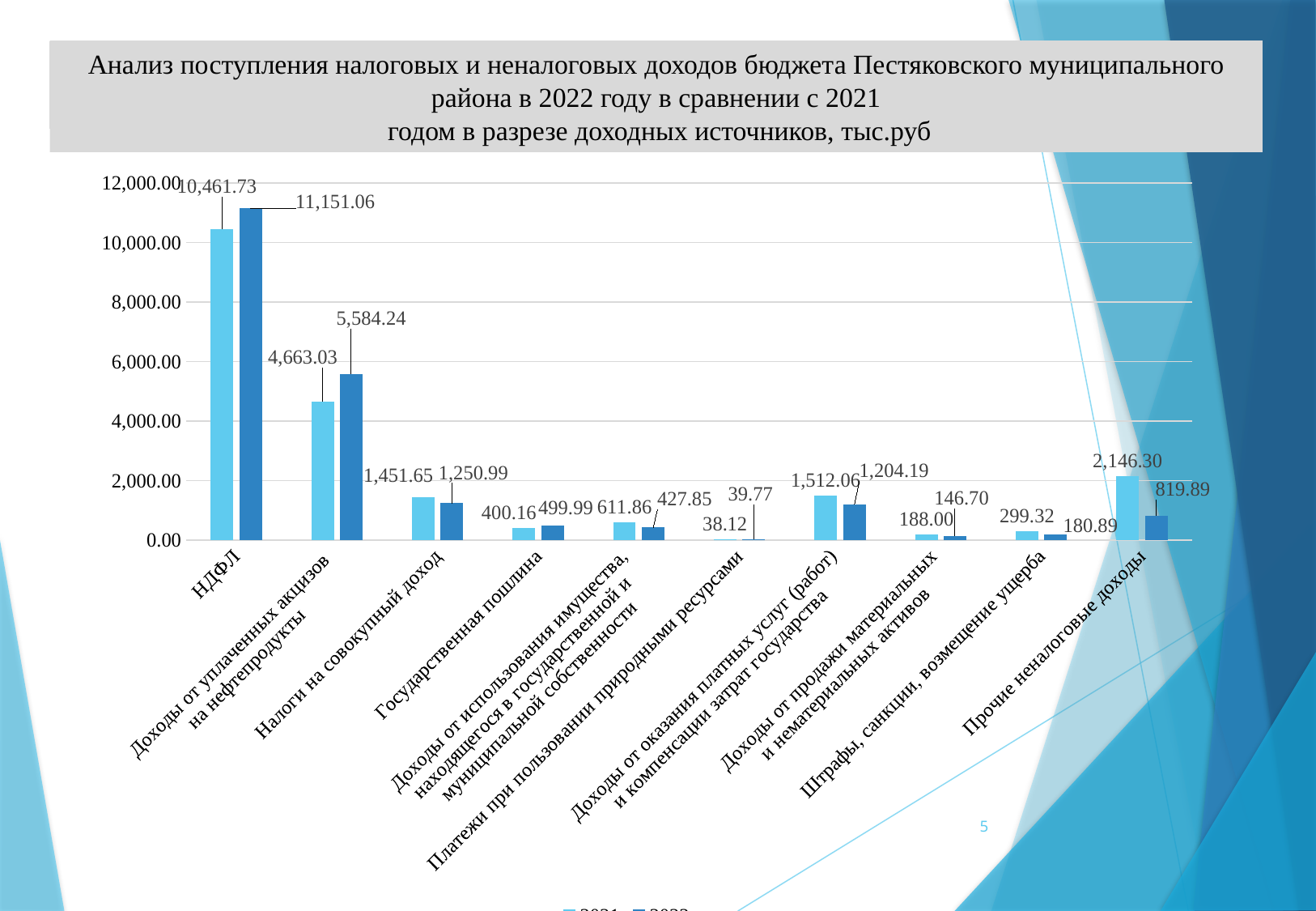
By how much did the value for НДФЛ increase from 2021 to 2022? 689.33 Which category has the lowest 2022 value? Платежи при пользовании природными ресурсами What is the 2022 value for Прочие неналоговые доходы? 819.89 What is the 2022 value for НДФЛ? 11,151.06 Which category has the highest 2021 value? НДФЛ For Налоги на совокупный доход, which year has the larger value, 2021 or 2022? 2021 In what units are the values on the chart expressed, according to the slide title? тыс.руб Is the 2022 value for Доходы от уплаченных акцизов на нефтепродукты greater or less than 4,000.00? greater What kind of chart is shown on the slide? bar chart What is the difference between the 2021 and 2022 values for Прочие неналоговые доходы? 1,326.41 How many income source categories are shown on the x axis? 10 What is the 2021 value for Государственная пошлина? 400.16